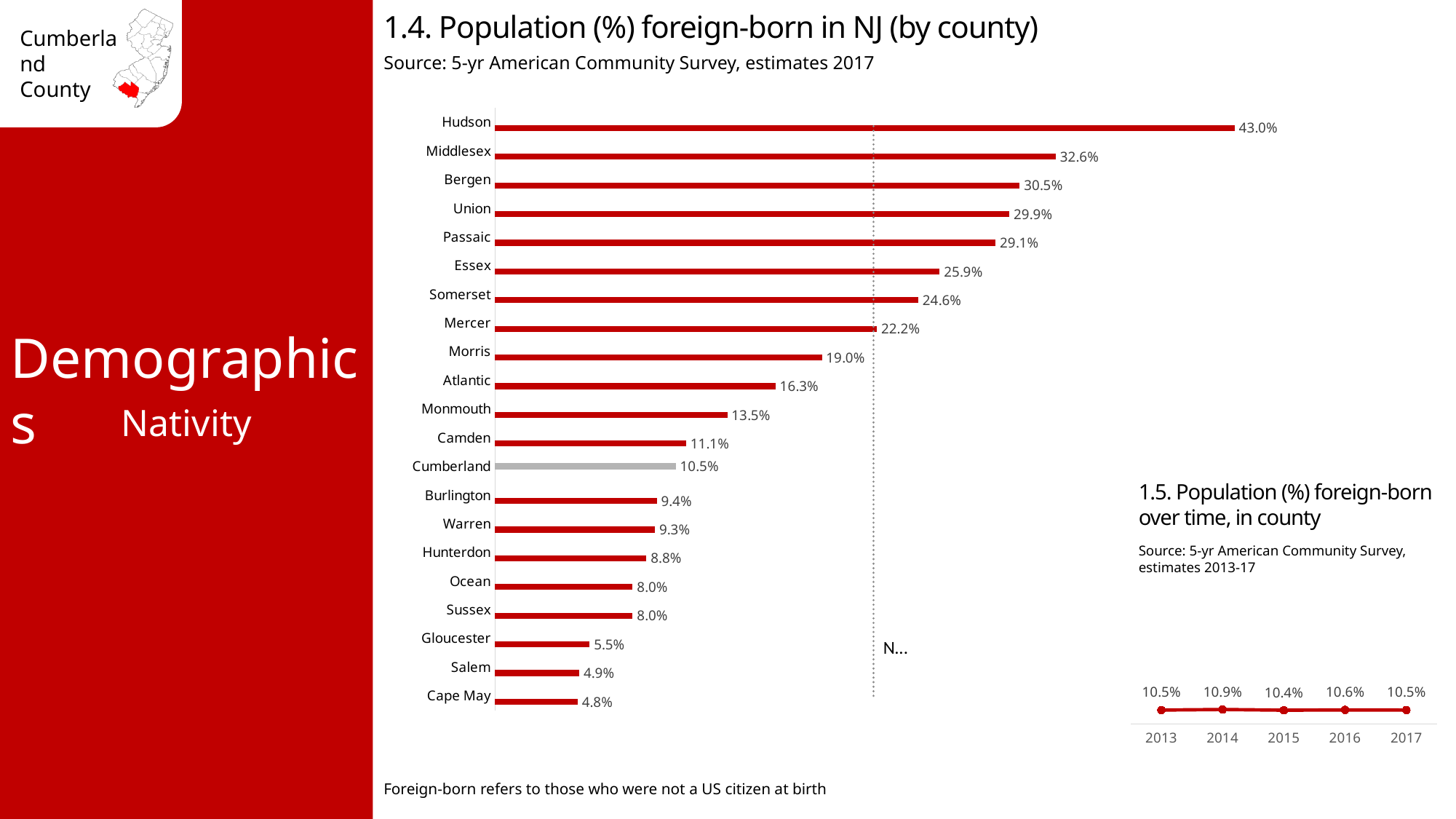
In chart 1.4 (Population (%) foreign-born in NJ by county), what is the value for Cumberland? 10.5% In chart 1.4 (Population (%) foreign-born in NJ by county), which county has the highest value? Hudson What kind of chart is chart 1.4 (Population (%) foreign-born in NJ by county)? Bar chart In chart 1.4 (Population (%) foreign-born in NJ by county), which county's bar is coloured grey instead of red? Cumberland In chart 1.5 (Population (%) foreign-born over time, in county), what is the value for 2014? 10.9% In chart 1.5 (Population (%) foreign-born over time, in county), how many years are plotted? 5 In chart 1.4 (Population (%) foreign-born in NJ by county), what is the difference between Middlesex and Bergen? 2.1% In chart 1.5 (Population (%) foreign-born over time, in county), which year has the lowest value? 2015 In chart 1.4 (Population (%) foreign-born in NJ by county), which is larger, Camden or Burlington? Camden In chart 1.4 (Population (%) foreign-born in NJ by county), how many counties are shown? 21 In chart 1.4 (Population (%) foreign-born in NJ by county), what is the value for Hudson? 43.0% In chart 1.4 (Population (%) foreign-born in NJ by county), which county has the lowest value? Cape May